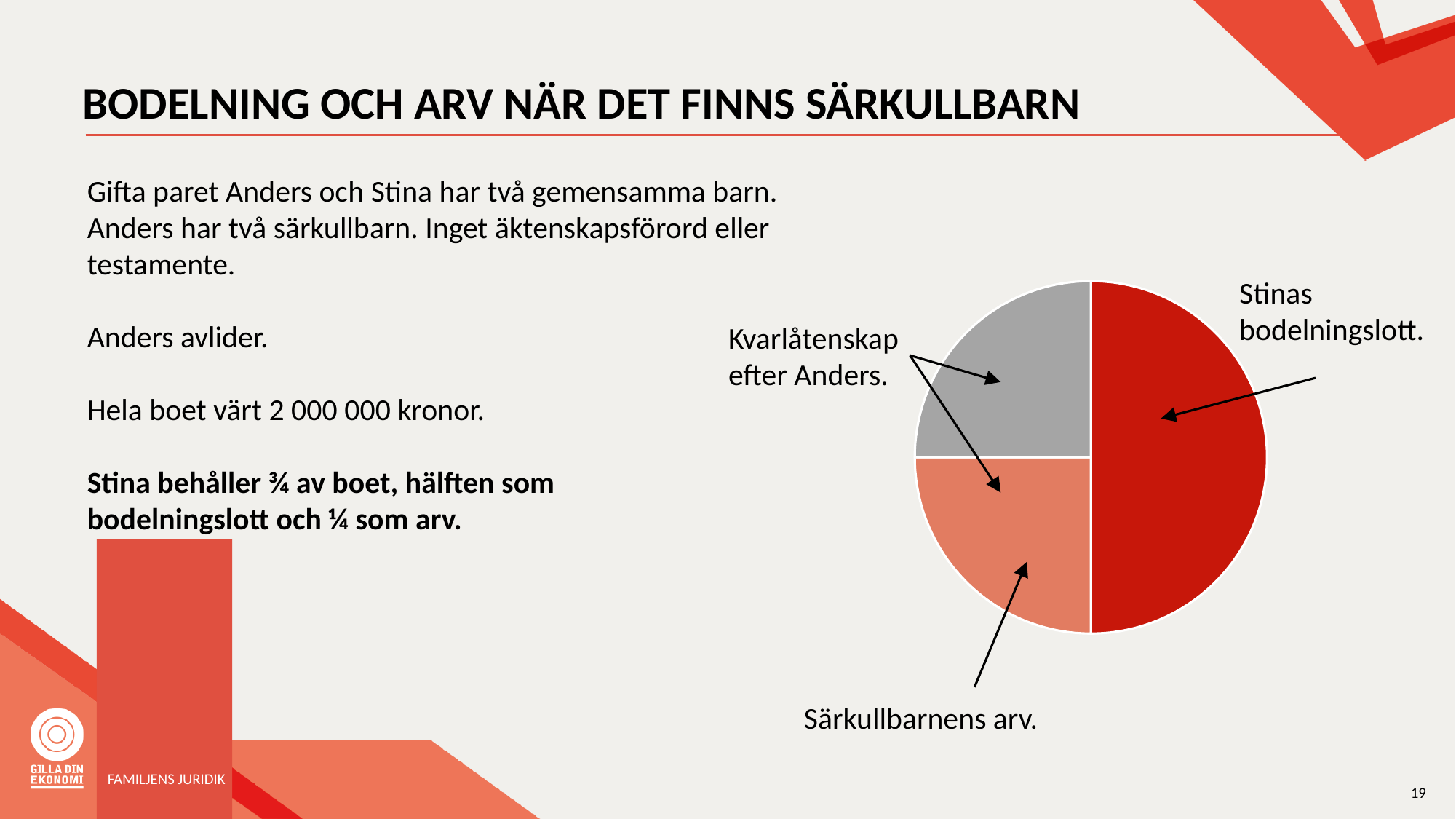
How many slices does the pie chart have? 3 What is the whole estate (hela boet) represented by the pie chart worth? 2 000 000 kronor What kind of chart is shown on the slide? pie chart Which label in the pie chart has arrows pointing to two slices? Kvarlåtenskap efter Anders Which is larger in the pie chart: Stinas bodelningslott or Särkullbarnens arv? Stinas bodelningslott What share of the whole estate does Stinas bodelningslott represent in the pie chart? hälften (half) Which slice of the pie chart is the largest? Stinas bodelningslott What colour is the slice labelled Stinas bodelningslott? dark red Which is larger in the pie chart: the grey slice or the dark red slice? the dark red slice